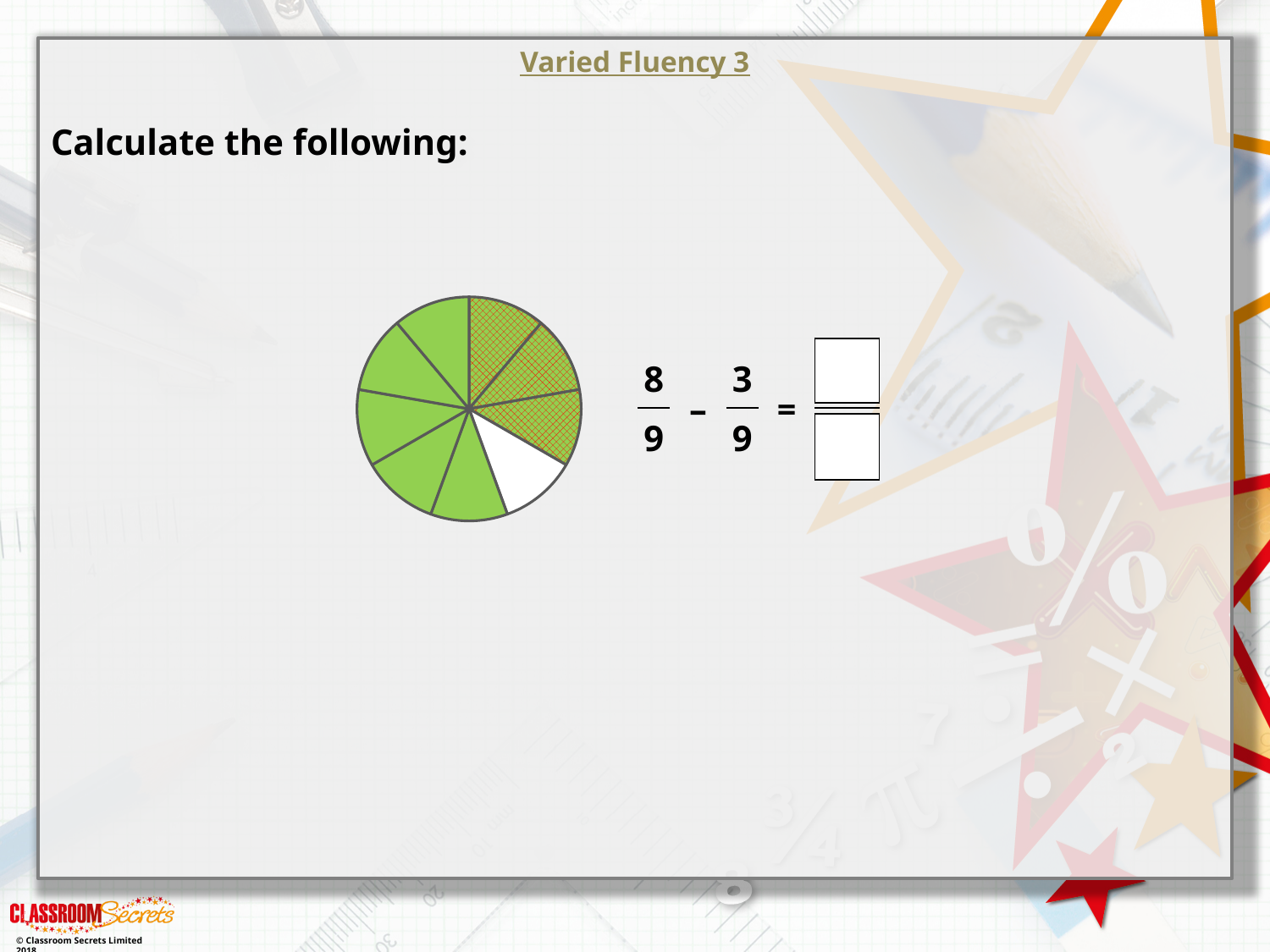
How many slices of the pie chart are plain green with no pattern? 5 Are there more plain green slices or more crosshatched slices in the pie chart? plain green Which type of slice appears least often in the pie chart: plain green, crosshatched green, or white? white Are all the slices of the pie chart the same size? yes How many slices is the pie chart divided into? 9 How many slices of the pie chart are green with an orange crosshatch pattern? 3 What is the denominator of the fractions in the calculation next to the pie chart? 9 Which type of slice appears most often in the pie chart: plain green, crosshatched green, or white? plain green What kind of chart is shown on the slide? pie chart